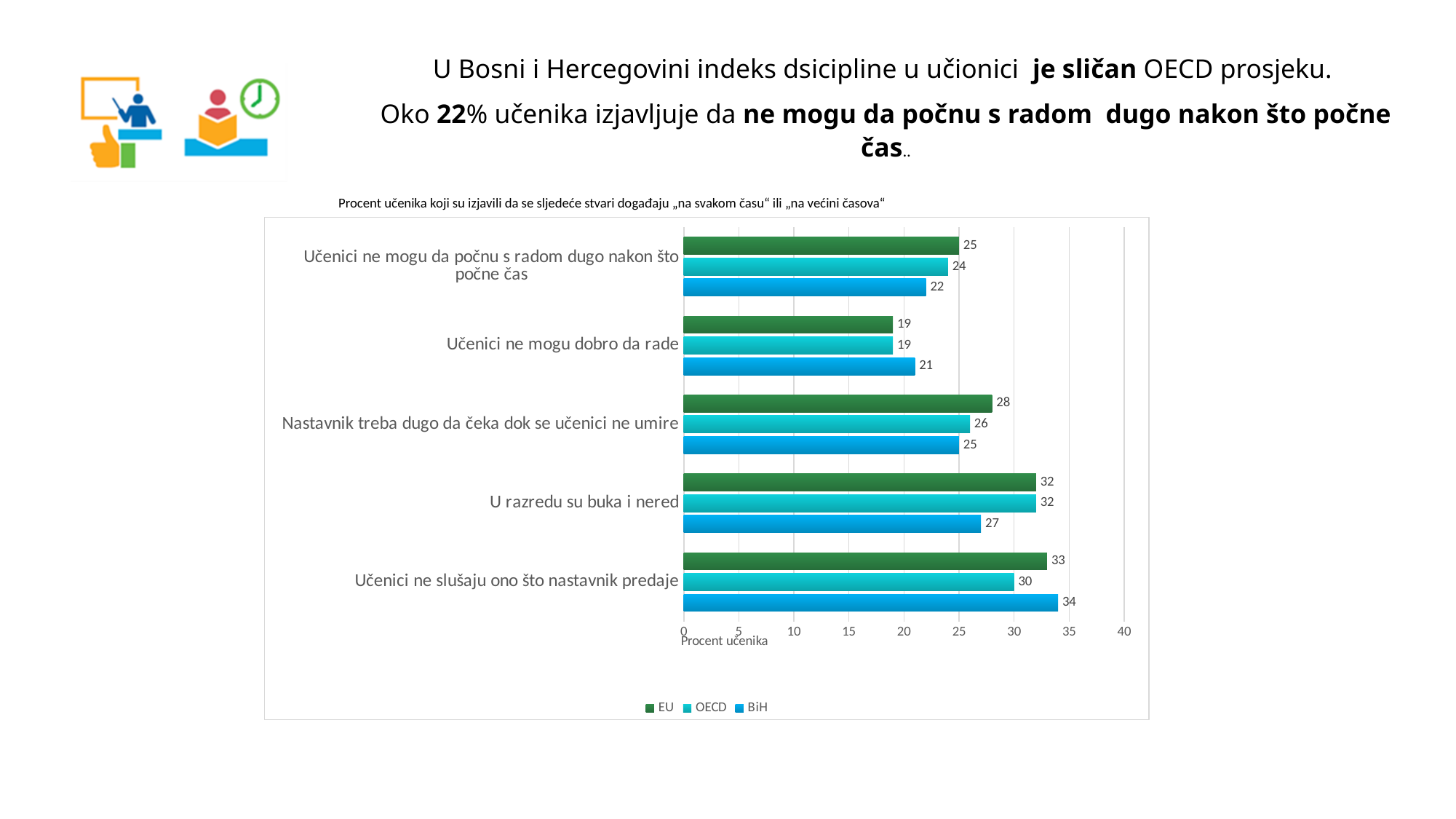
What is the OECD value for "Učenici ne slušaju ono što nastavnik predaje"? 30 Which category has the highest BiH value? Učenici ne slušaju ono što nastavnik predaje What kind of chart is shown on the slide? Bar chart What is the difference between the BiH and OECD values for "U razredu su buka i nered"? 5 What is the BiH value for "Učenici ne mogu da počnu s radom dugo nakon što počne čas"? 22 For "Učenici ne mogu dobro da rade", which is larger, the BiH value or the EU value? BiH Is the BiH value for "Učenici ne slušaju ono što nastavnik predaje" greater or less than 30? greater How many categories are shown on the y axis of the chart? 5 What is the EU value for "Nastavnik treba dugo da čeka dok se učenici ne umire"? 28 How many series does the legend list? 3 Which category has the lowest EU value? Učenici ne mogu dobro da rade What is the label of the x axis of the chart? Procent učenika